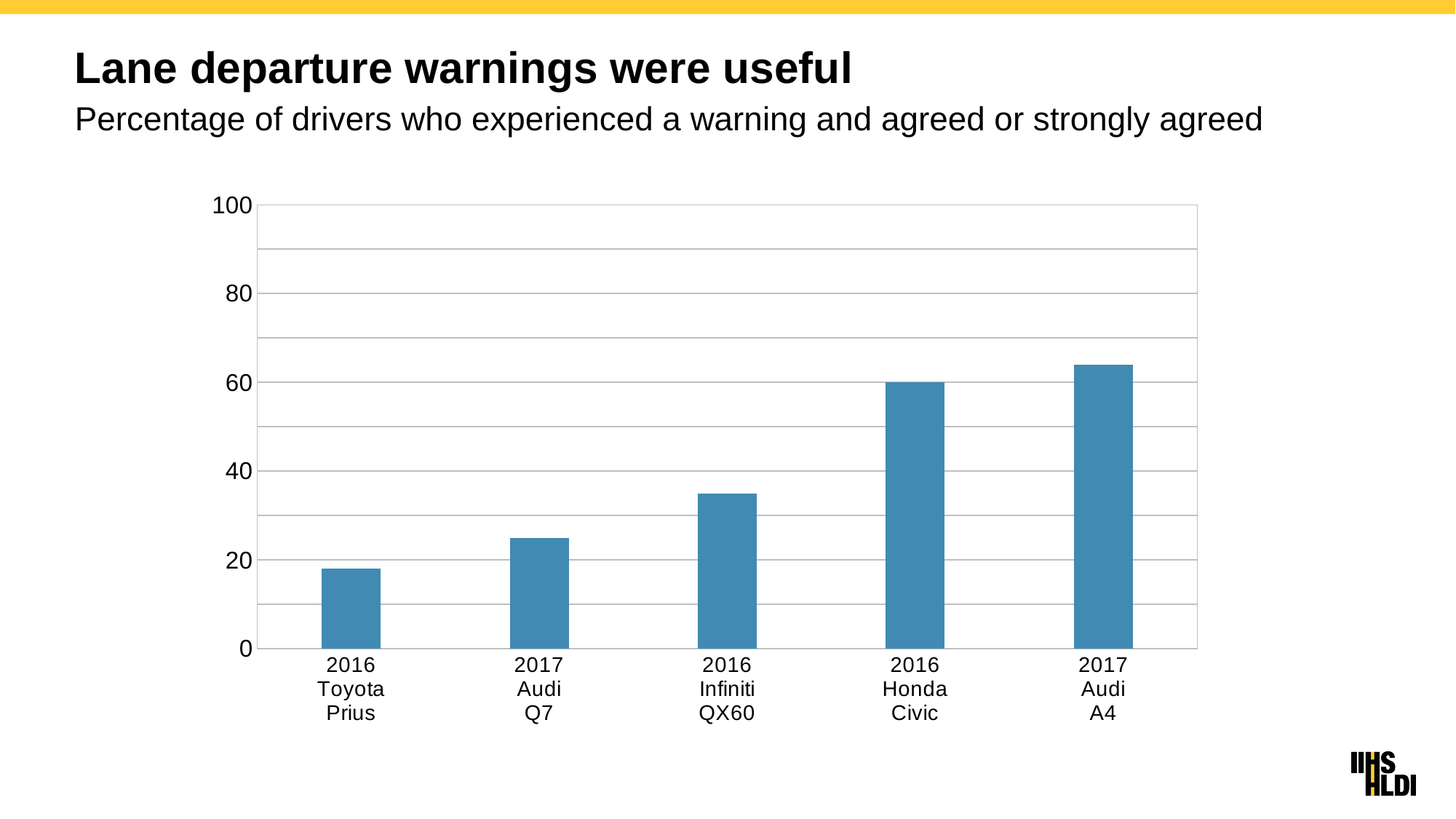
How many vehicle categories are shown on the x axis? 5 Which is larger, the value for the 2016 Honda Civic or the 2016 Infiniti QX60? 2016 Honda Civic Is the value for the 2016 Infiniti QX60 greater or less than 40? less Do the values rise or fall moving from left to right along the x axis? rise What kind of chart is shown on the slide? bar chart What is the title of the slide containing the chart? Lane departure warnings were useful Is the value for the 2017 Audi Q7 greater or less than 20? greater Is the value for the 2017 Audi A4 greater or less than 60? greater Which vehicle has the lowest percentage of drivers who agreed or strongly agreed? 2016 Toyota Prius What is the highest value shown on the vertical axis? 100 Which vehicle has the highest percentage of drivers who agreed or strongly agreed? 2017 Audi A4